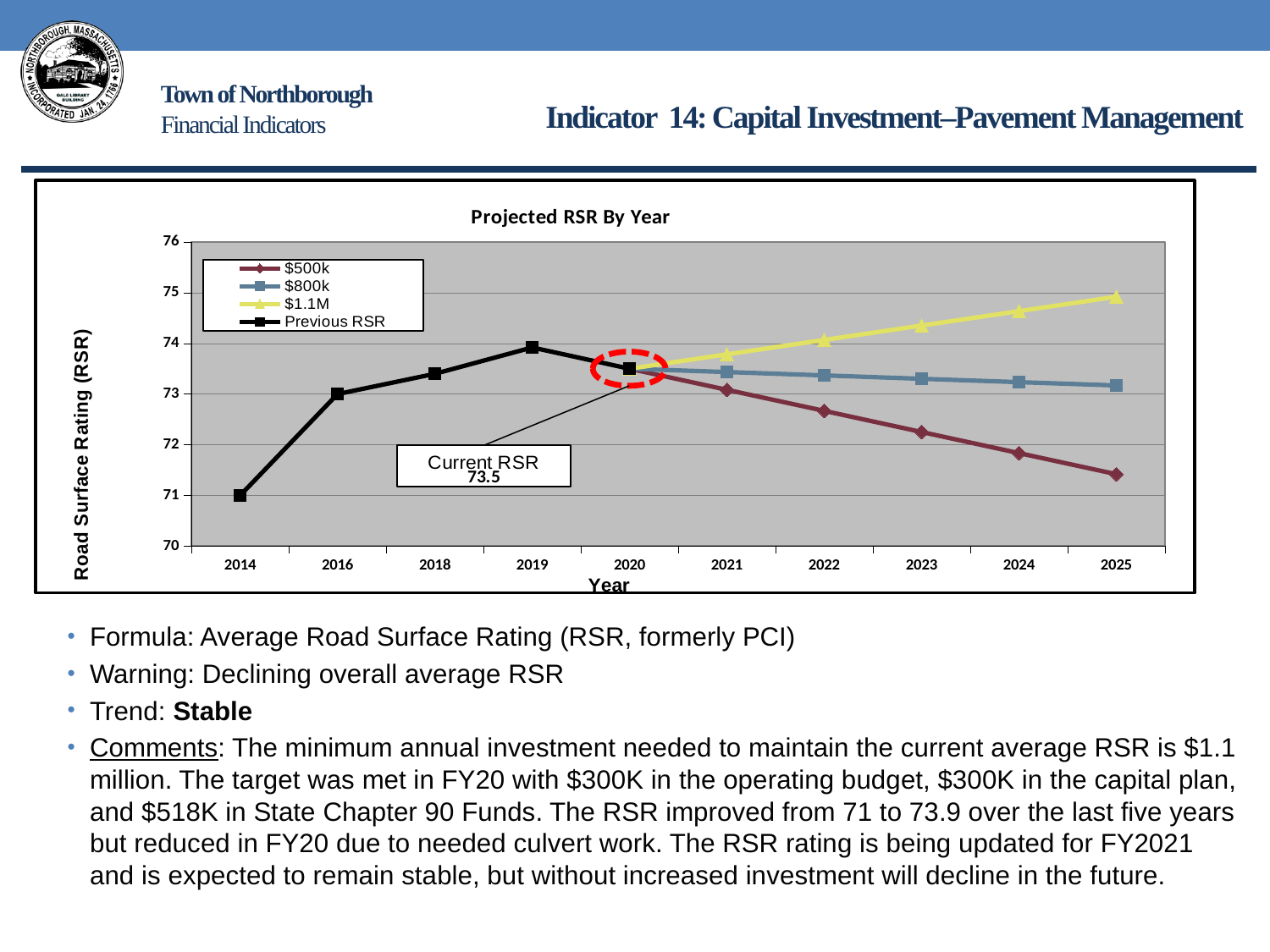
What is the Current RSR value labelled on the chart for 2020? 73.5 Does the Previous RSR series rise or fall from 2014 to 2019? rise Does the $500k series rise or fall from 2021 to 2025? fall What type of chart is shown on the slide? line chart Is the value for the $1.1M series in 2025 greater or less than 74? greater How many series does the chart legend list? 4 What is the title of the chart? Projected RSR By Year Which series has the lowest value in 2025? $500k Is the value for the $800k series in 2025 greater or less than 74? less How many years are shown on the x axis of the chart? 10 Which series has the highest value in 2025? $1.1M Is the value for the $500k series in 2025 greater or less than 72? less